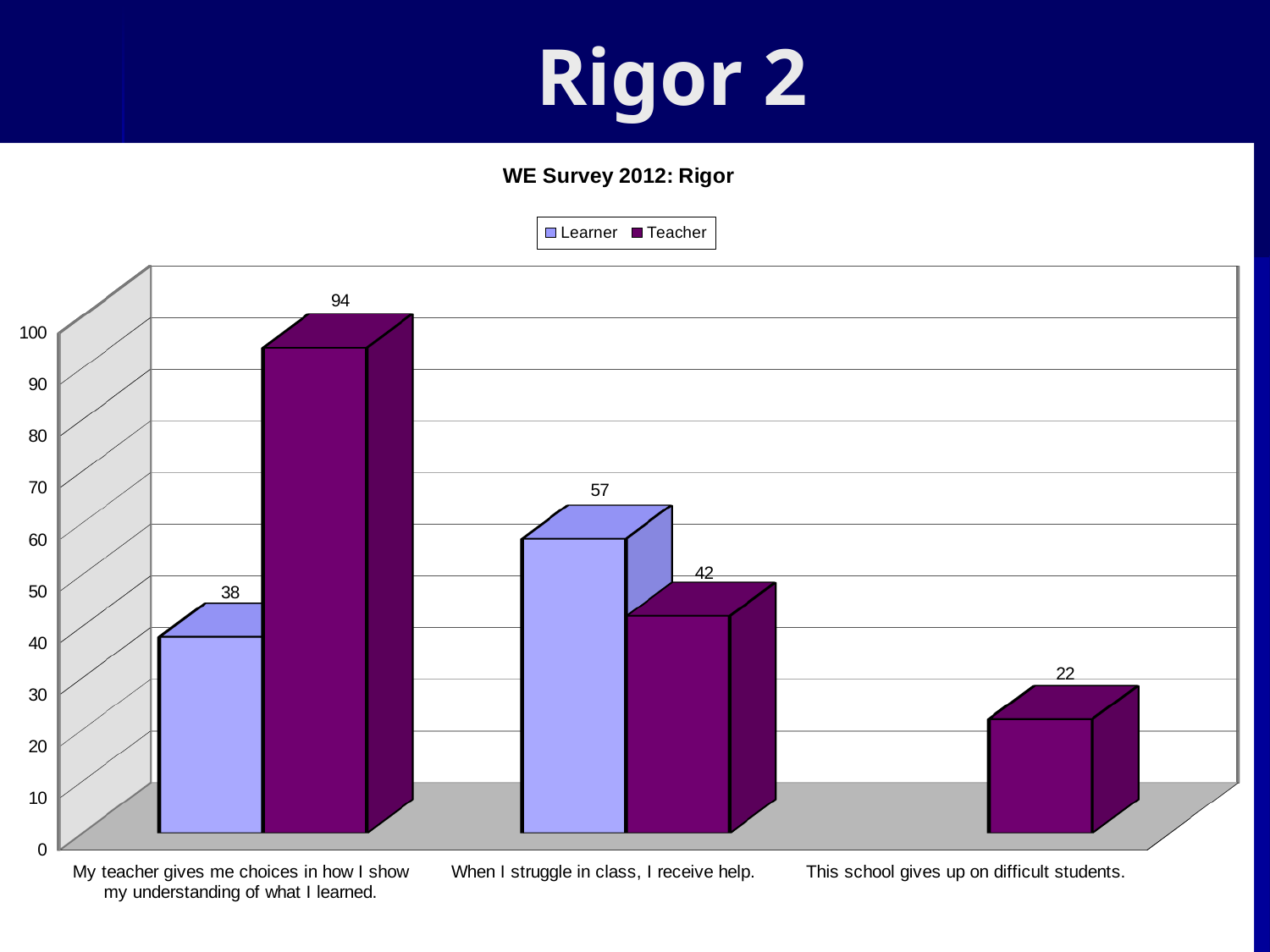
How many series does the legend list? 2 What is the title of the chart? WE Survey 2012: Rigor What is the Learner value for "When I struggle in class, I receive help."? 57 For "When I struggle in class, I receive help.", which is larger, the Learner value or the Teacher value? Learner What is the difference between the Learner and Teacher values for "When I struggle in class, I receive help."? 15 Which category has the highest Teacher value? My teacher gives me choices in how I show my understanding of what I learned. What is the Learner value for "My teacher gives me choices in how I show my understanding of what I learned."? 38 What kind of chart is shown on the slide? Bar chart What is the Teacher value for "This school gives up on difficult students."? 22 What is the difference between the Teacher and Learner values for "My teacher gives me choices in how I show my understanding of what I learned."? 56 Which category has the lowest Teacher value? This school gives up on difficult students. What is the Teacher value for "My teacher gives me choices in how I show my understanding of what I learned."? 94